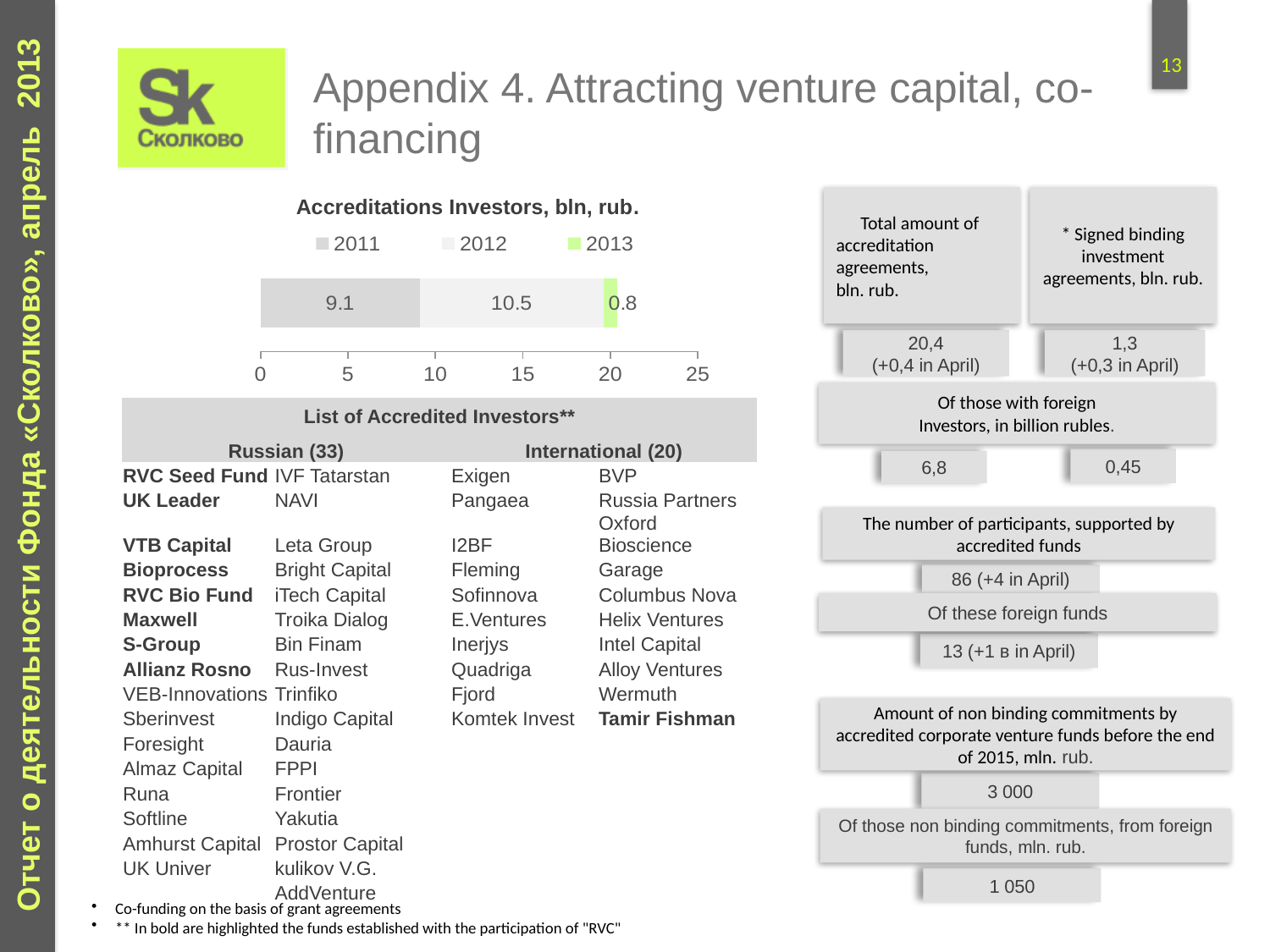
Which year has the highest value in the Accreditations Investors chart? 2012 How many series does the legend of the Accreditations Investors chart list? 3 What kind of chart is the Accreditations Investors chart? Stacked bar chart What is the total of the stacked bar in the Accreditations Investors chart? 20.4 What is the difference between the 2012 and 2011 values in the Accreditations Investors chart? 1.4 What is the maximum value shown on the x axis of the Accreditations Investors chart? 25 Which year has the lowest value in the Accreditations Investors chart? 2013 What is the value for 2013 in the Accreditations Investors chart? 0.8 What is the value for 2012 in the Accreditations Investors chart? 10.5 What is the value for 2011 in the Accreditations Investors chart? 9.1 What is the title of the chart on the slide? Accreditations Investors, bln, rub. Which is larger in the Accreditations Investors chart, the value for 2011 or the value for 2013? 2011